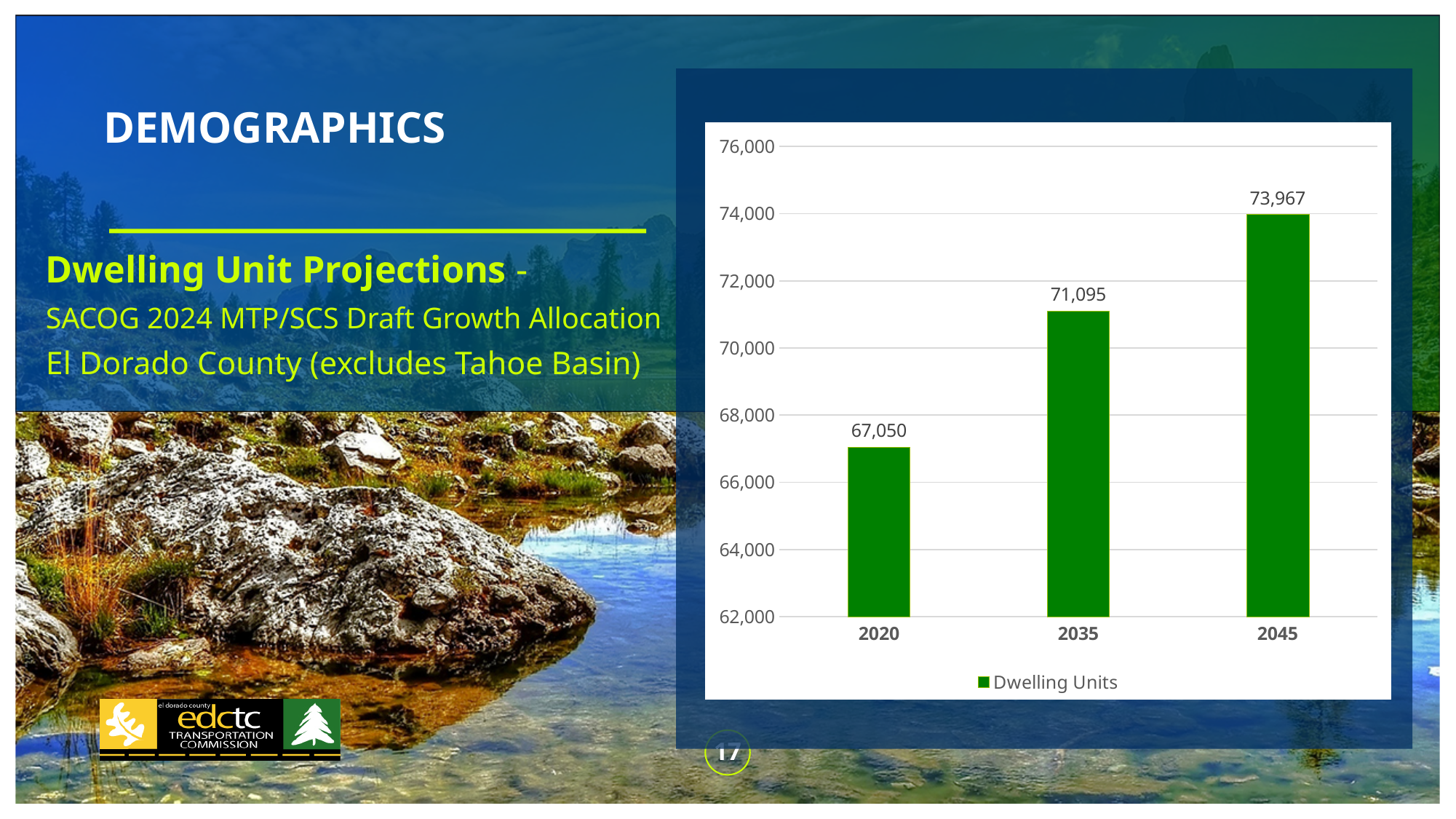
Do the Dwelling Units values rise or fall from 2020 to 2045? Rise What is the value of Dwelling Units for 2020? 67,050 Which year has the lowest number of Dwelling Units? 2020 Which year has more Dwelling Units, 2035 or 2045? 2045 What is the difference in Dwelling Units between 2045 and 2020? 6,917 What is the value of Dwelling Units for 2045? 73,967 What kind of chart is shown on the slide? Bar chart Which year has the highest number of Dwelling Units? 2045 What is the difference in Dwelling Units between 2035 and 2020? 4,045 How many years are shown on the x axis of the chart? 3 Is the value for 2035 greater or less than 70,000? greater What is the value of Dwelling Units for 2035? 71,095